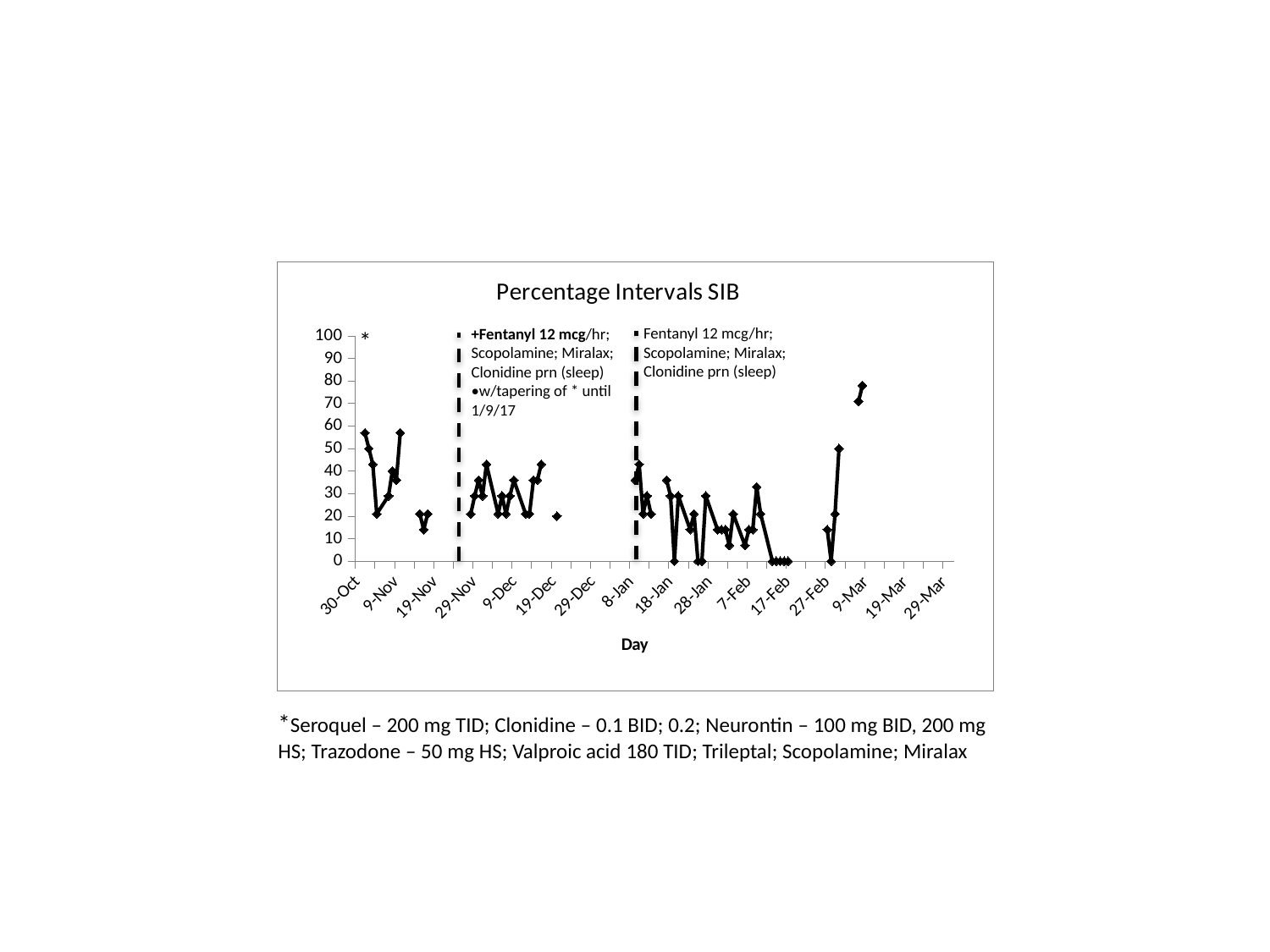
What kind of chart is shown on the slide? Line chart Is the highest plotted value, near 9-Mar, greater or less than 60? greater How many dashed vertical lines divide the chart into phases? 2 What is the label on the x axis of the chart? Day What is the title of the chart? Percentage Intervals SIB Are the plotted values around 17-Feb greater or less than 10? less What is the lowest value that the plotted points reach on the y axis? 0 Is the value plotted near 9-Mar larger or smaller than the value plotted near 17-Feb? larger Is the first plotted value, at 30-Oct, greater or less than 40? greater Around which x-axis date does the chart reach its highest plotted value? 9-Mar